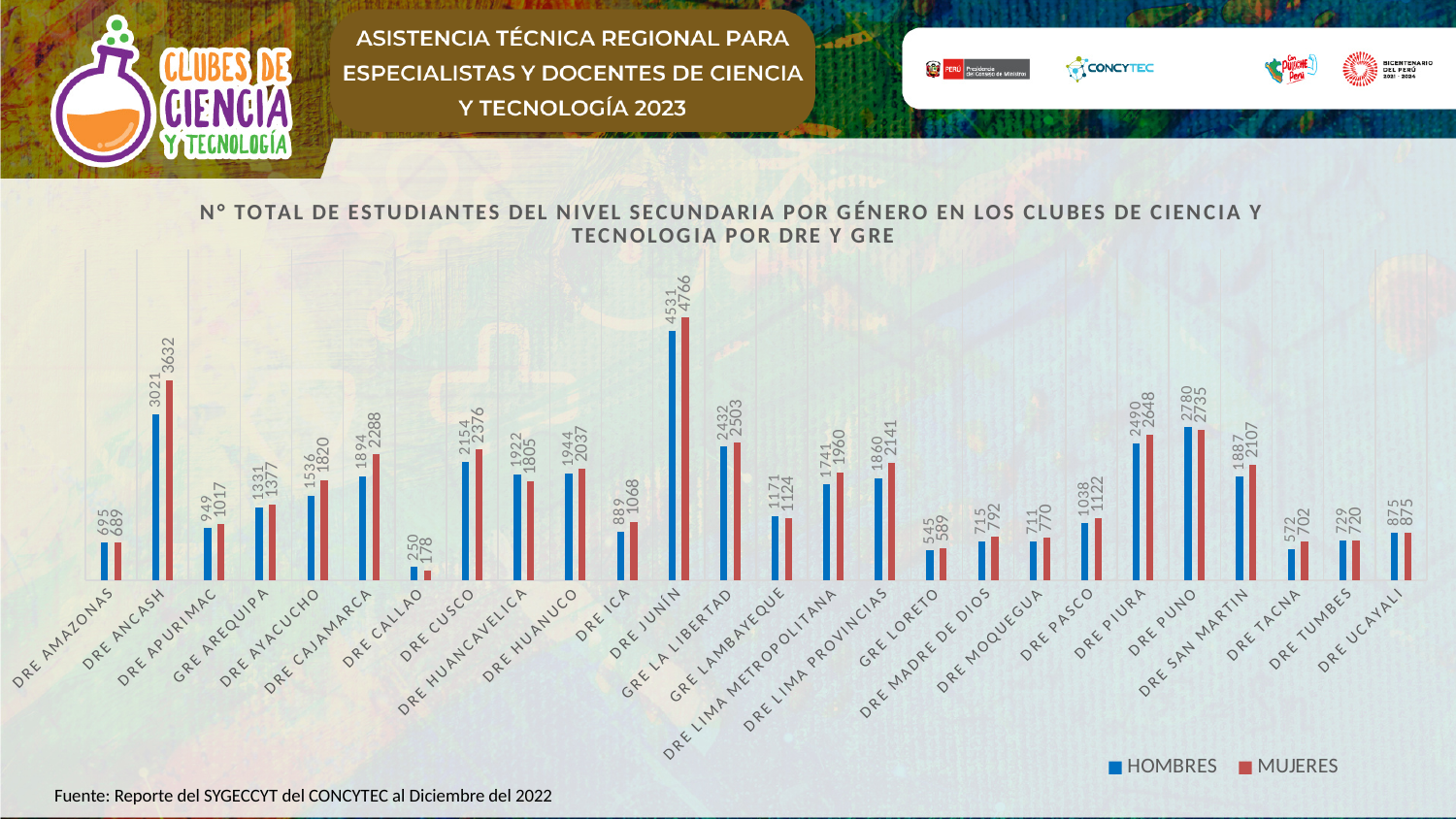
Which category has the highest value for HOMBRES? DRE JUNÍN What type of chart is shown on the slide? Bar chart What is the value for HOMBRES in DRE CUSCO? 2154 What is the value for MUJERES in DRE TACNA? 702 What colour represents the MUJERES series in the chart? Red What is the value for MUJERES in DRE ANCASH? 3632 Which is larger in DRE PUNO, HOMBRES or MUJERES? HOMBRES How many series does the legend list? 2 What is the difference between MUJERES and HOMBRES in DRE JUNÍN? 235 How many DRE/GRE categories are plotted on the chart? 26 What is the total of HOMBRES and MUJERES in DRE CALLAO? 428 Which category has the lowest value for MUJERES? DRE CALLAO